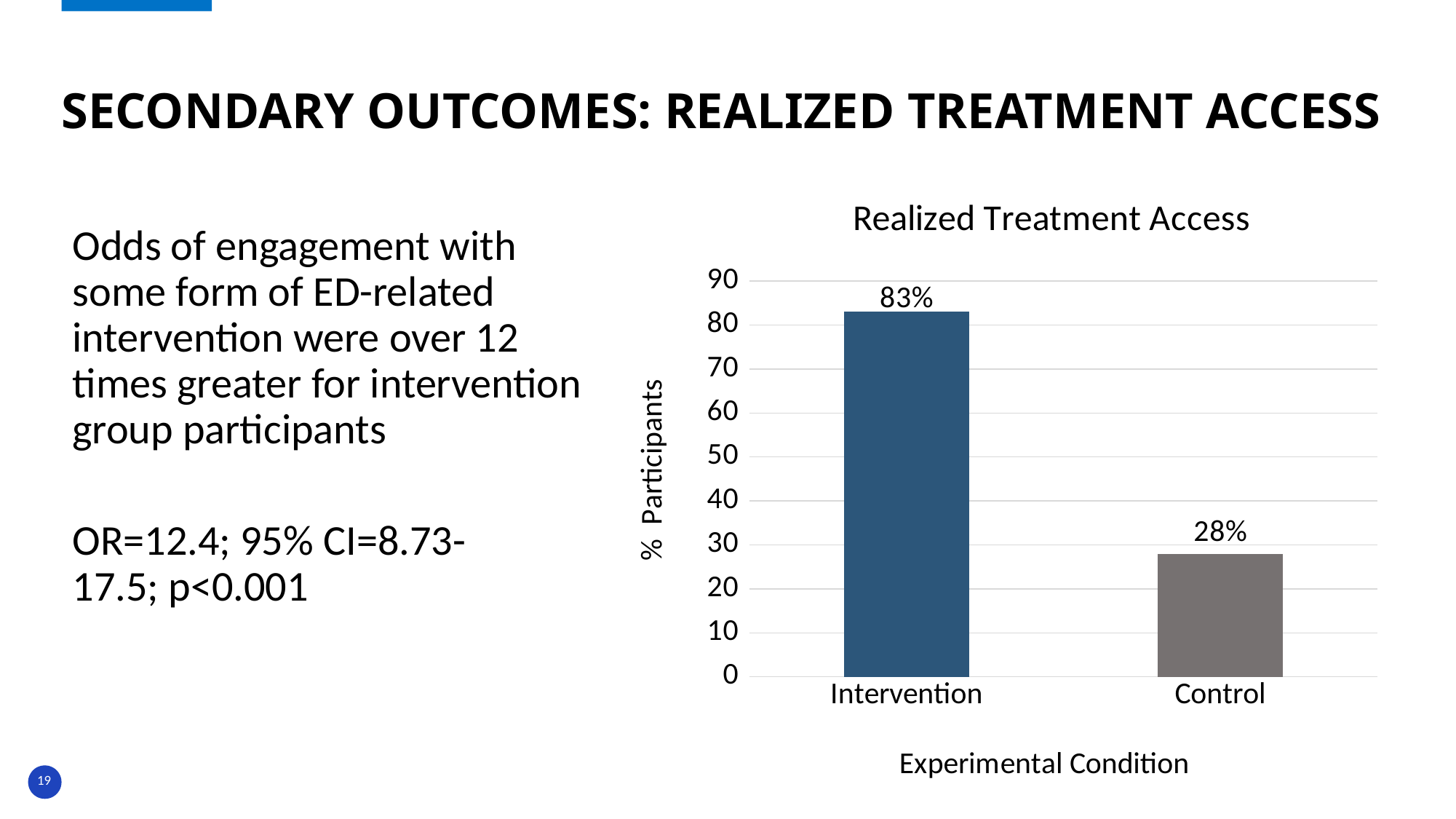
Which is larger, the value for Intervention or the value for Control? Intervention How many experimental conditions are shown in the chart? 2 What is the value for Intervention in the Realized Treatment Access chart? 83% What is the difference in percentage points between the Intervention and Control bars? 55 What is the value for Control in the Realized Treatment Access chart? 28% What is the title of the chart? Realized Treatment Access What is the label of the x axis of the chart? Experimental Condition Which experimental condition has the lowest percentage of participants with realized treatment access? Control Is the value for Control greater or less than 30? less Which experimental condition has the highest percentage of participants with realized treatment access? Intervention What kind of chart is shown on the slide? Bar chart Is the value for Intervention greater or less than 80? greater